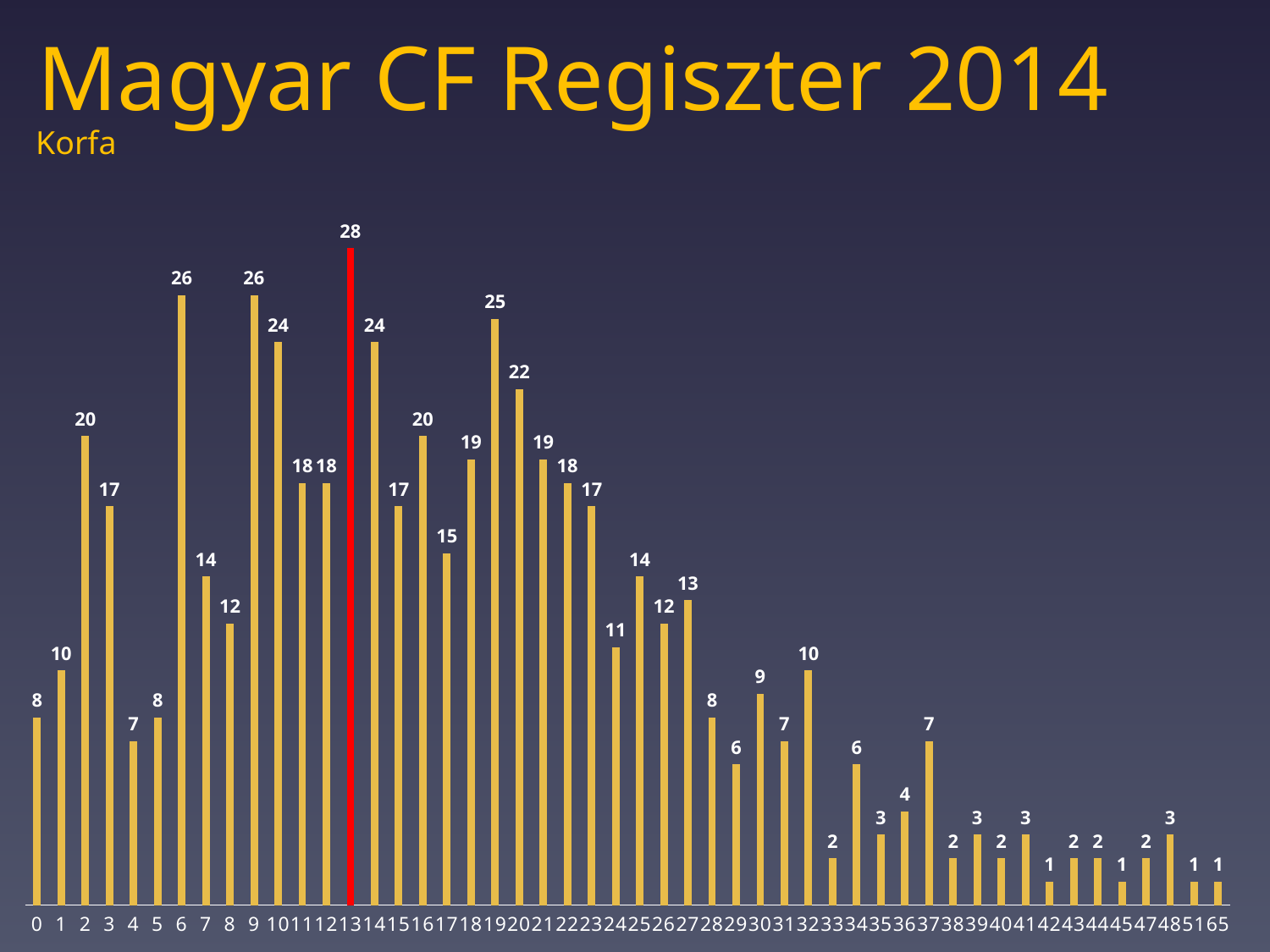
What is the value for age 32? 10 What is the difference between the values for age 13 and age 6? 2 What is the lowest value shown on the chart? 1 What is the value for age 13, the bar highlighted in red? 28 What is the value for age 2? 20 What is the title of the chart on the slide? Magyar CF Regiszter 2014 What is the difference between the values for age 20 and age 24? 11 Which is larger, the value for age 10 or the value for age 14? They are equal (24) What is the value for age 19? 25 What type of chart is shown on the slide? bar chart Which is larger, the value for age 16 or the value for age 17? age 16 Which age category has the highest value? 13